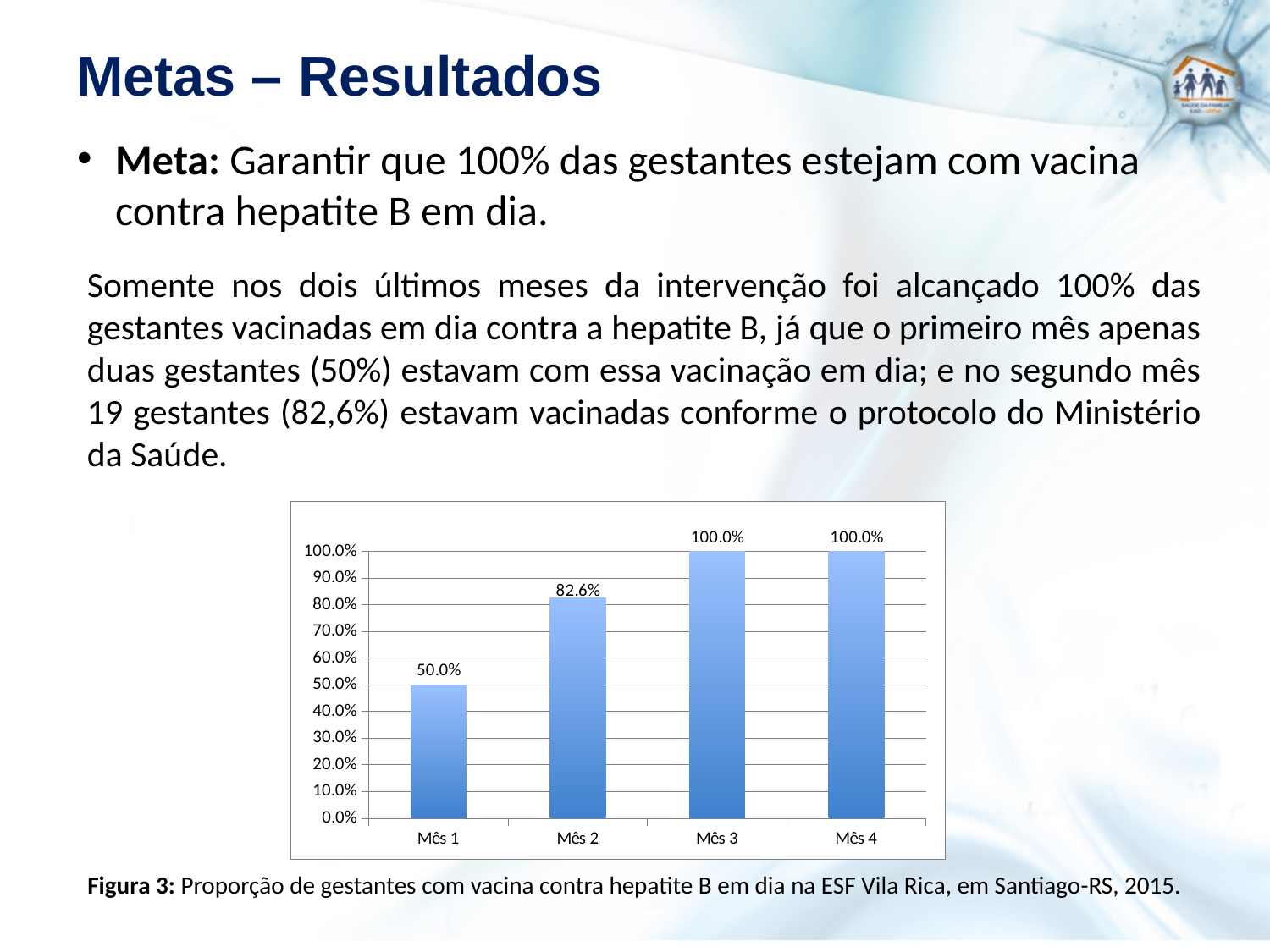
What kind of chart is shown on the slide? bar chart What is the value for Mês 2? 82.6% Which month has the lowest value? Mês 1 Is the value for Mês 2 greater or less than 80.0%? greater What is the value for Mês 3? 100.0% Do the values rise or fall from Mês 1 to Mês 4? rise What is the value for Mês 1? 50.0% What is the difference between the values for Mês 3 and Mês 2? 17.4% What is the difference between the values for Mês 2 and Mês 1? 32.6% Which is larger, the value for Mês 1 or the value for Mês 2? Mês 2 What is the highest value shown on the y axis? 100.0% How many months are shown on the x axis? 4